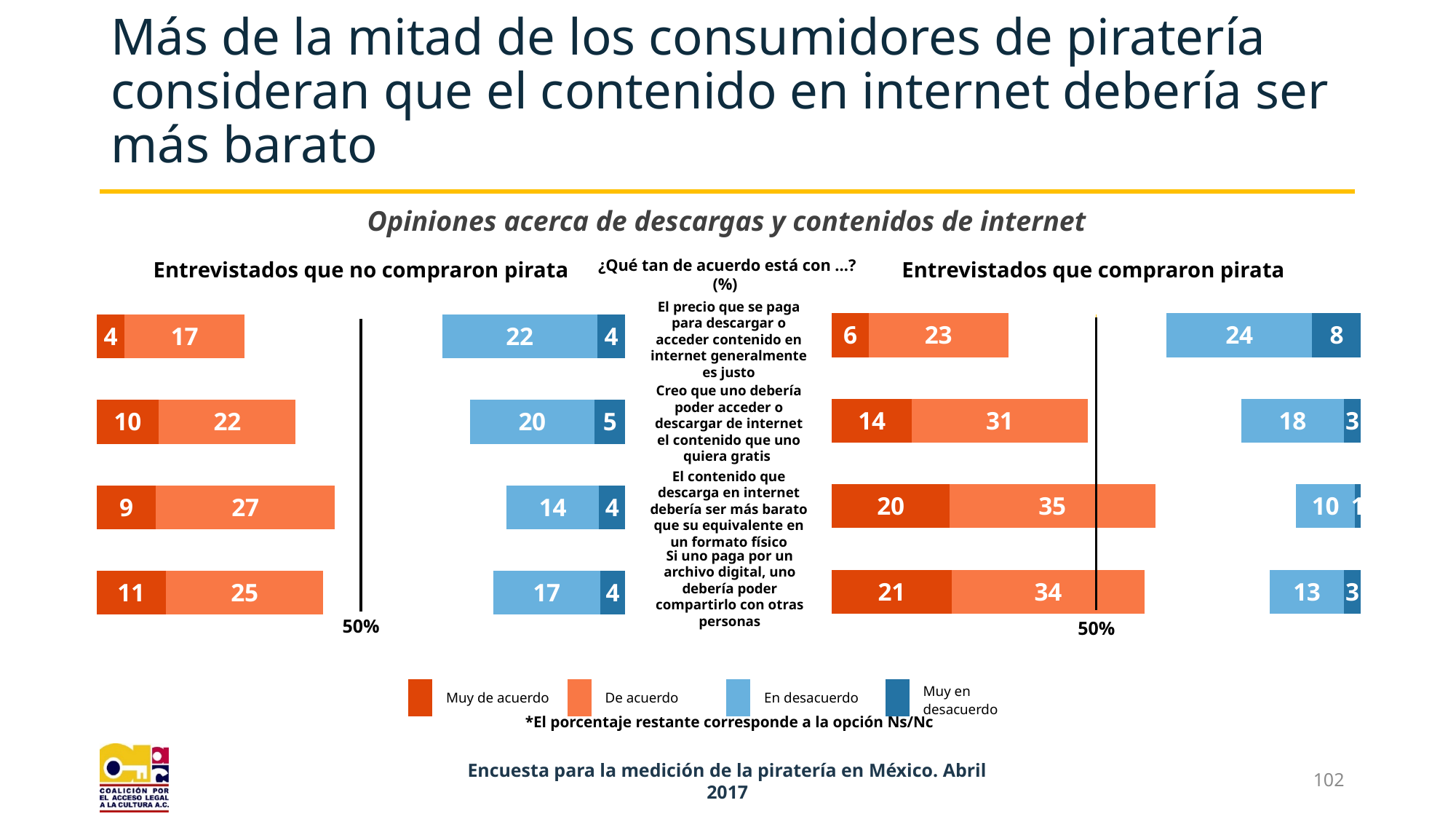
Comparing the two charts, is the 'Muy de acuerdo' value for the 'compartirlo con otras personas' statement larger among those who bought pirated goods or those who did not? Those who bought pirated goods (Entrevistados que compraron pirata) What kind of chart is used on this slide? Stacked bar chart In the chart 'Entrevistados que no compraron pirata', what is the 'De acuerdo' value for the statement that the price paid to download or access content on the internet is generally fair? 17 In the chart 'Entrevistados que no compraron pirata', what is the 'En desacuerdo' value for the statement that one should be able to access or download internet content for free? 20 In the chart 'Entrevistados que no compraron pirata', what is the difference between the 'De acuerdo' values for the 'más barato' statement and the 'precio justo' statement? 10 In the chart 'Entrevistados que compraron pirata', which statement has the highest 'De acuerdo' value? El contenido que descarga en internet debería ser más barato que su equivalente en un formato físico In the chart 'Entrevistados que no compraron pirata', which statement has the lowest 'Muy de acuerdo' value? El precio que se paga para descargar o acceder contenido en internet generalmente es justo In the chart 'Entrevistados que compraron pirata', what is the 'Muy en desacuerdo' value for the statement that the price paid for internet content is generally fair? 8 How many statements are shown in each chart? 4 How many series does the legend list? 4 In the chart 'Entrevistados que compraron pirata', what is the combined 'Muy de acuerdo' plus 'De acuerdo' total for the statement that if one pays for a digital file, one should be able to share it with others? 55 In the chart 'Entrevistados que compraron pirata', what is the 'Muy de acuerdo' value for the statement that content downloaded from the internet should be cheaper than its physical equivalent? 20